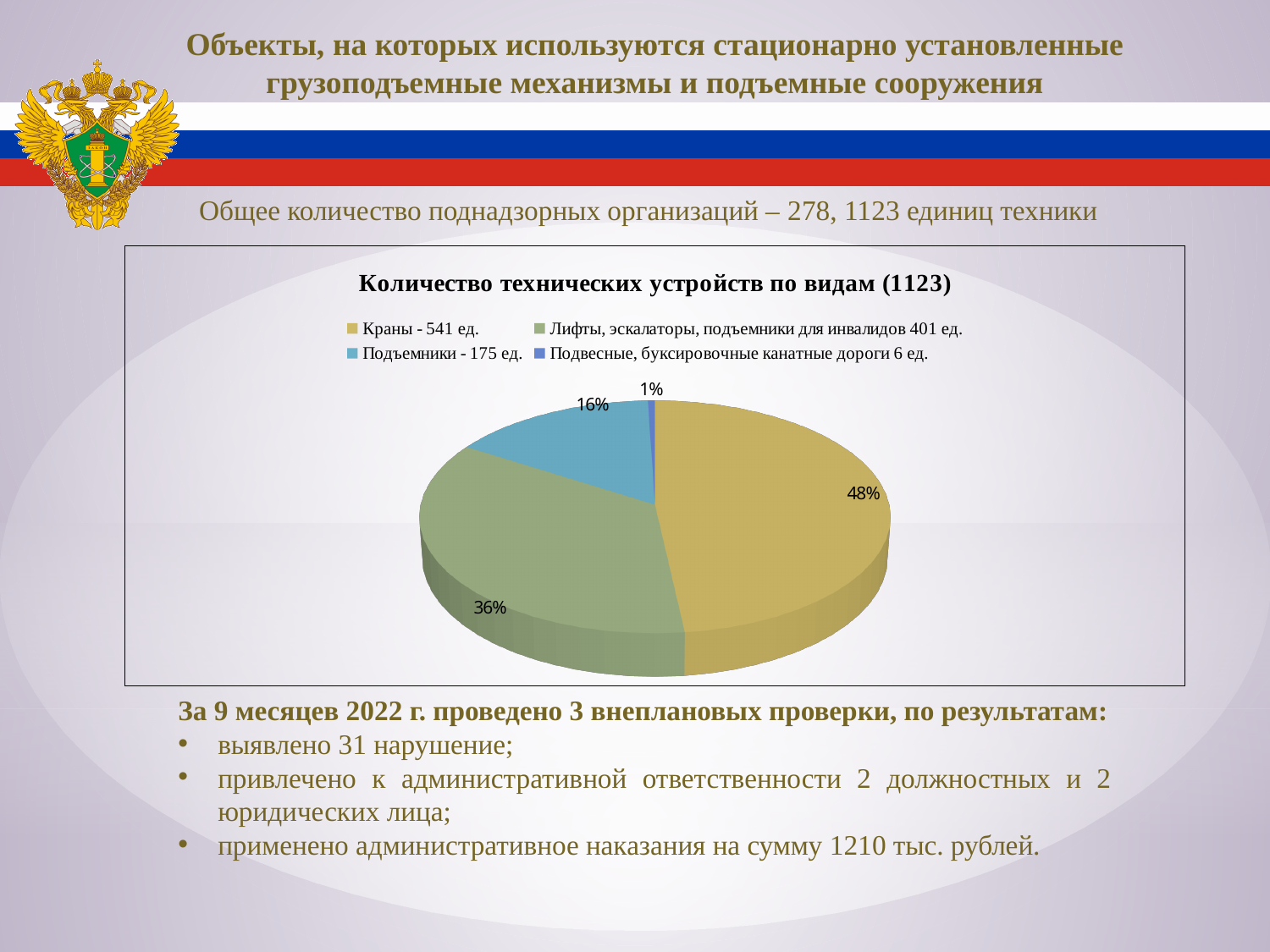
What is the title of the pie chart? Количество технических устройств по видам (1123) What share of the pie does the 'Лифты, эскалаторы, подъемники для инвалидов' slice represent? 36% What share of the pie does the 'Подвесные, буксировочные канатные дороги' slice represent? 1% What kind of chart is shown on the slide? pie chart Which has more units according to the legend: 'Подъемники' or 'Подвесные, буксировочные канатные дороги'? Подъемники How many categories does the pie chart show? 4 Which category has the largest slice of the pie? Краны What share of the pie does the 'Подъемники' slice represent? 16% What is the difference in units between 'Краны' (541) and 'Лифты, эскалаторы, подъемники для инвалидов' (401) as given in the legend? 140 Which category has the smallest slice of the pie? Подвесные, буксировочные канатные дороги According to the legend, how many units are there for 'Краны'? 541 ед.